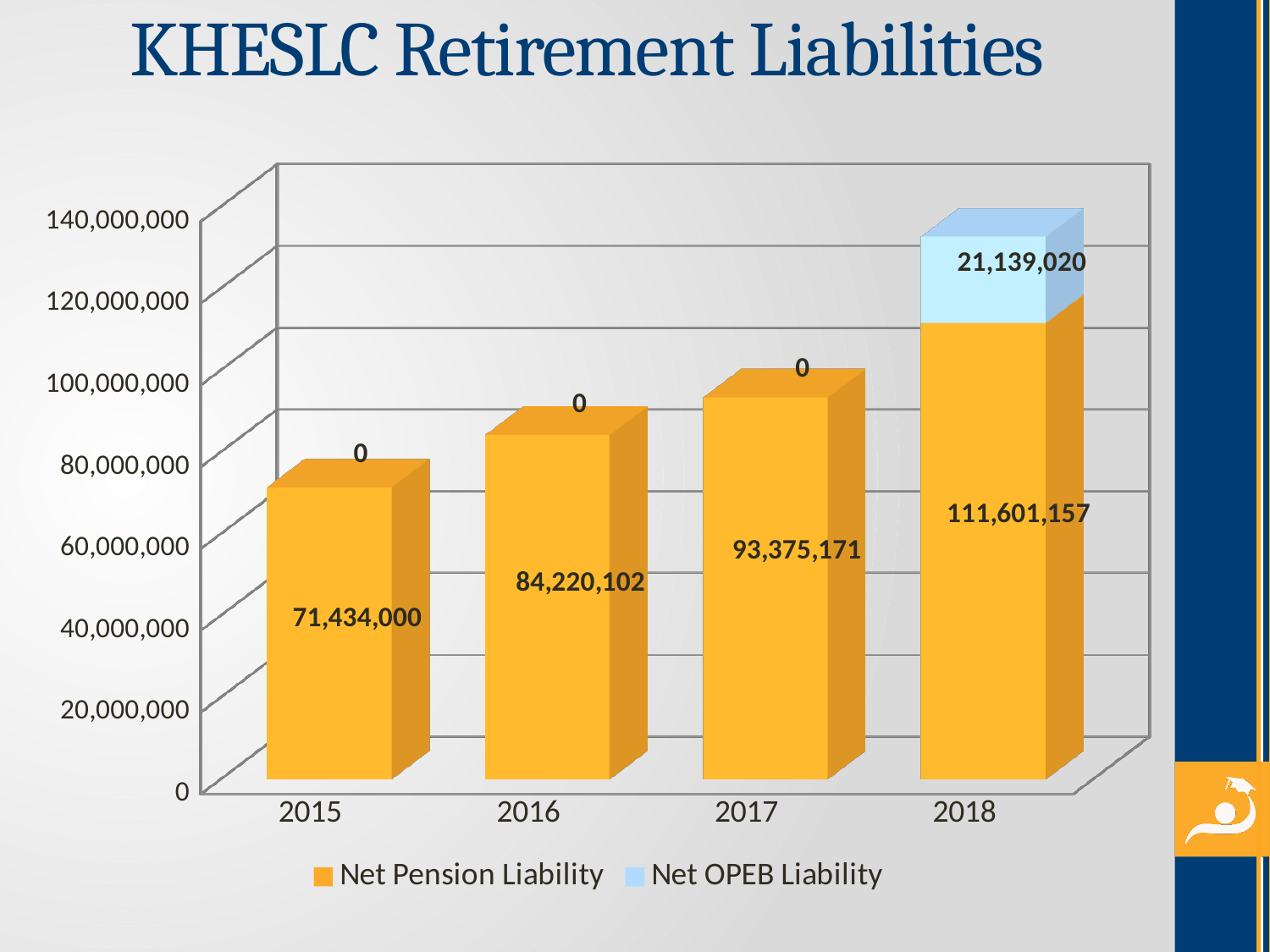
What is the total liability (Net Pension plus Net OPEB) for 2018? 132,740,177 How many years are shown on the x axis? 4 What is the Net Pension Liability for 2017? 93,375,171 Which year has the highest Net Pension Liability? 2018 Is the Net Pension Liability for 2016 larger or smaller than for 2017? smaller Which year has the lowest Net Pension Liability? 2015 How many series does the legend list? 2 What is the difference between the Net Pension Liability in 2018 and in 2017? 18,225,986 What is the Net OPEB Liability for 2018? 21,139,020 What is the Net OPEB Liability for 2016? 0 Does the Net Pension Liability rise or fall from 2015 to 2018? rise What is the Net Pension Liability for 2015? 71,434,000